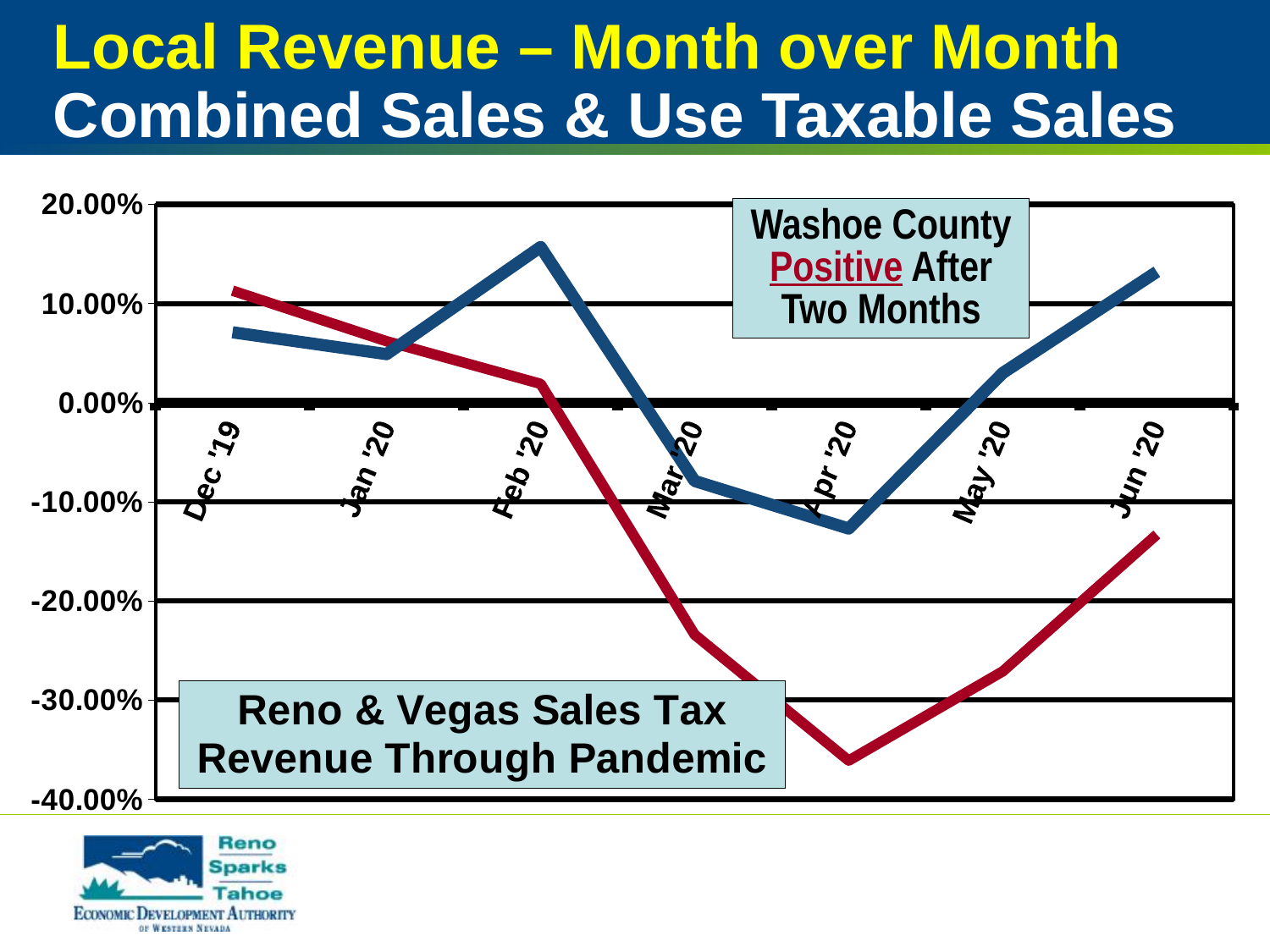
In which month does the blue line reach its highest value? Feb '20 How many months are plotted along the x axis? 7 Is the value of the blue line for Mar '20 greater or less than 0.00%? less Is the value of the red line for Apr '20 greater or less than -30.00%? less At Apr '20, which line has the higher value, the blue line or the red line? Blue line What kind of chart is shown on the slide? Line chart Is the value of the blue line for Feb '20 greater or less than 10.00%? greater Does the blue line rise or fall from Apr '20 to Jun '20? Rise Does the red line rise or fall from Feb '20 to Apr '20? Fall What does the text box in the upper right of the chart say? Washoe County Positive After Two Months In which month does the red line reach its lowest value? Apr '20